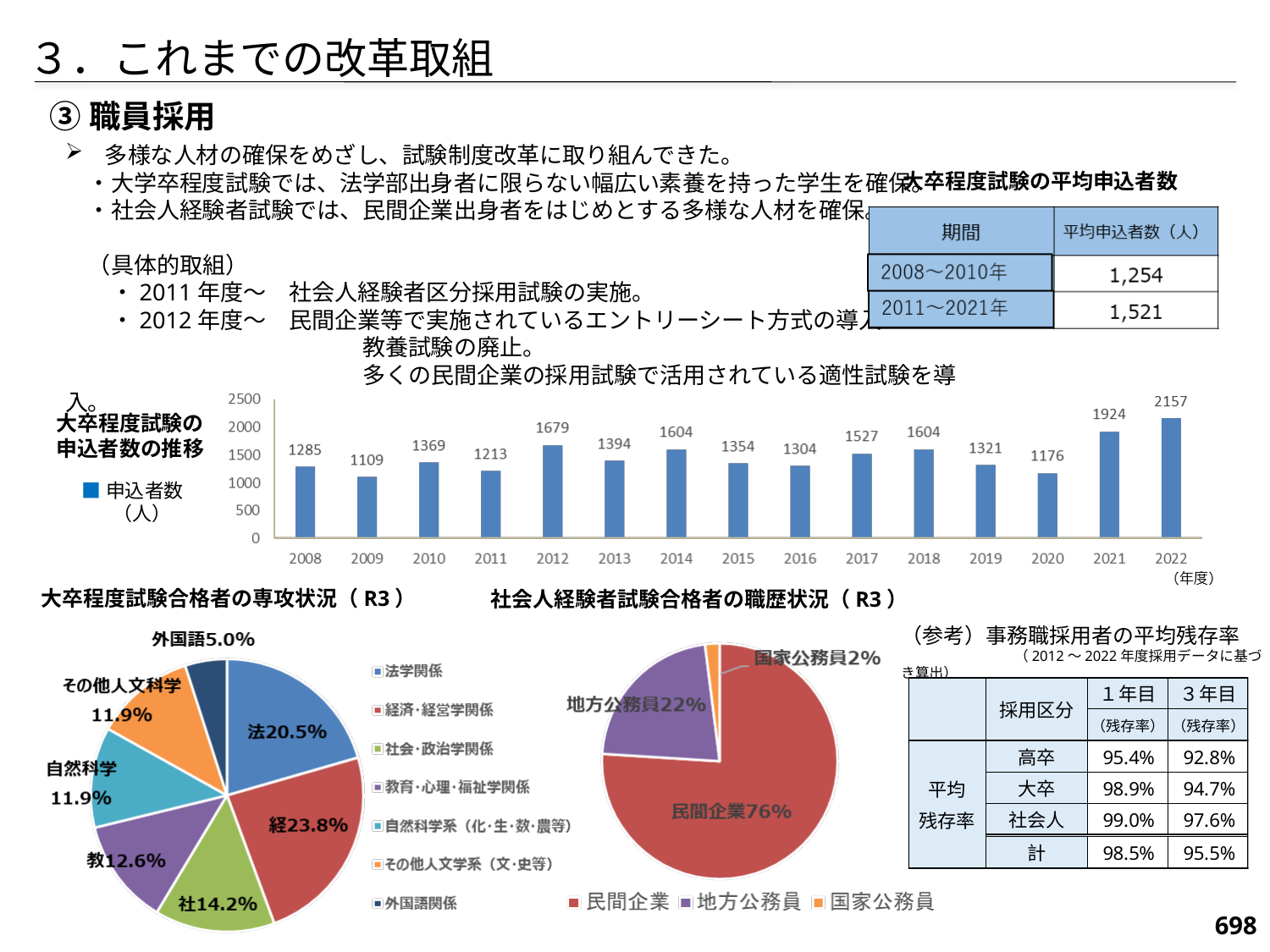
In the bar chart 大卒程度試験の申込者数の推移, what is the difference between the values for 2022 and 2021? 233 In the bar chart 大卒程度試験の申込者数の推移, how many years are shown on the x axis? 15 In the bar chart 大卒程度試験の申込者数の推移, which year has the lowest number of applicants? 2009 In the pie chart 大卒程度試験合格者の専攻状況（R3）, what is the share for 経済・経営学関係? 23.8% In the pie chart 社会人経験者試験合格者の職歴状況（R3）, how many categories does the legend list? 3 In the bar chart 大卒程度試験の申込者数の推移, which year has the highest number of applicants? 2022 In the bar chart 大卒程度試験の申込者数の推移, is the value for 2020 greater or less than 1500? less In the pie chart 大卒程度試験合格者の専攻状況（R3）, which category has the smallest share? 外国語関係 In the bar chart 大卒程度試験の申込者数の推移, what is the value for 2012? 1679 In the pie chart 社会人経験者試験合格者の職歴状況（R3）, what is the share for 地方公務員? 22% What kind of chart is 大卒程度試験の申込者数の推移? bar chart In the bar chart 大卒程度試験の申込者数の推移, what is the value for 2022? 2157